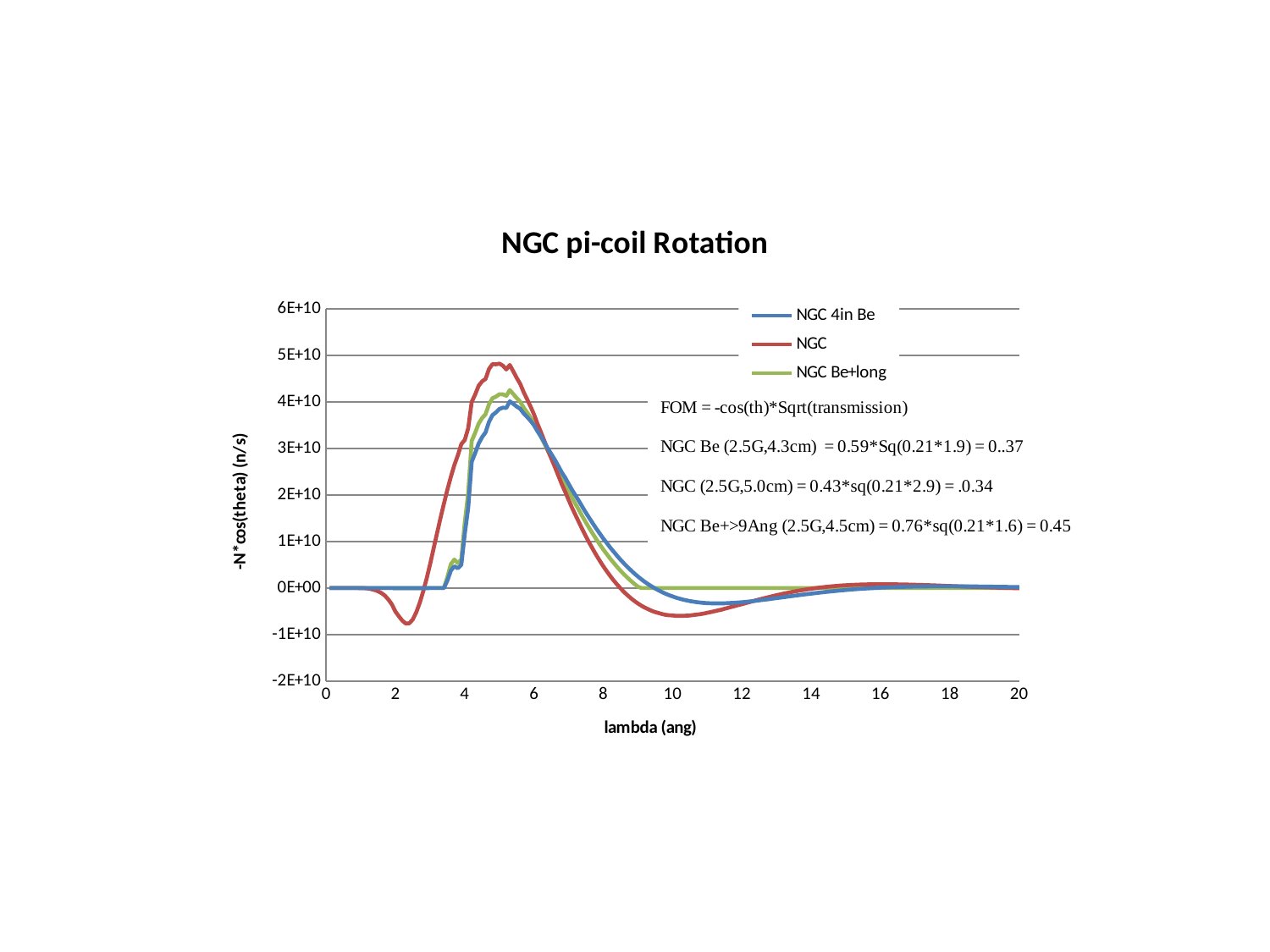
What is the title of the chart? NGC pi-coil Rotation How many series does the legend list? 3 Is the value of the NGC series at lambda 10 greater or less than 0E+00? less What kind of chart is shown on the slide? line chart What is the maximum value shown on the x axis? 20 Do the values of the NGC 4in Be series rise or fall between lambda 6 and lambda 8? fall Is the value of the NGC series at lambda 2 greater or less than 0E+00? less Is the peak value of the NGC series greater or less than 4E+10? greater Which series dips below zero between lambda 1 and lambda 3? NGC Which series reaches the highest peak value? NGC What is the label of the x axis? lambda (ang) At lambda 8, which series has the larger value, NGC 4in Be or NGC? NGC 4in Be